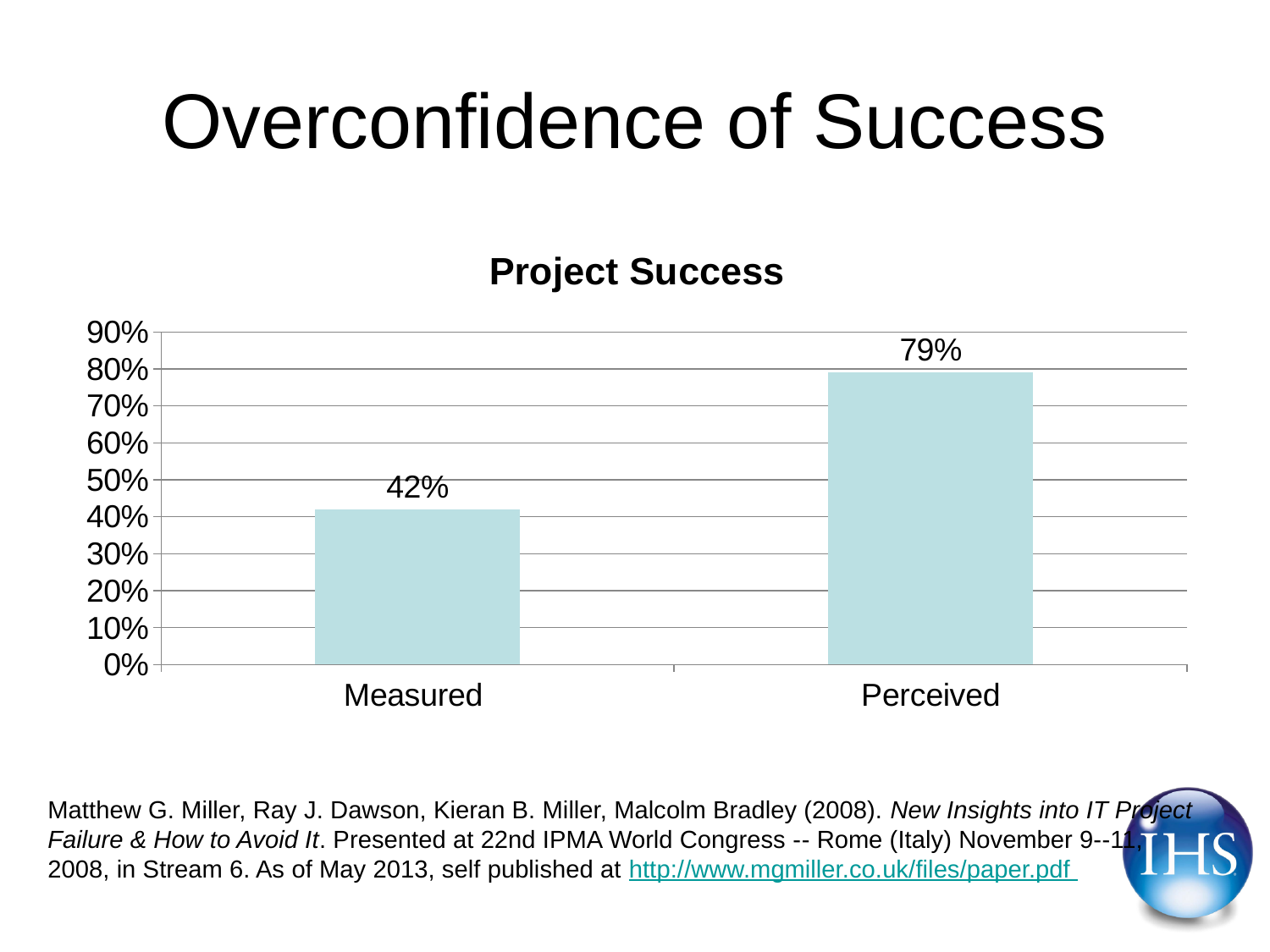
Is the value for Measured greater or less than 50%? less Which category has the lowest value? Measured What is the highest value shown on the vertical axis? 90% Which is larger, the value for Measured or the value for Perceived? Perceived Is the value for Perceived greater or less than 70%? greater What kind of chart is shown on the slide? bar chart What is the value for Perceived? 79% What is the value for Measured? 42% What is the title of the chart? Project Success What is the difference between the Perceived and Measured values? 37% How many categories are shown in the chart? 2 Which category has the highest value? Perceived